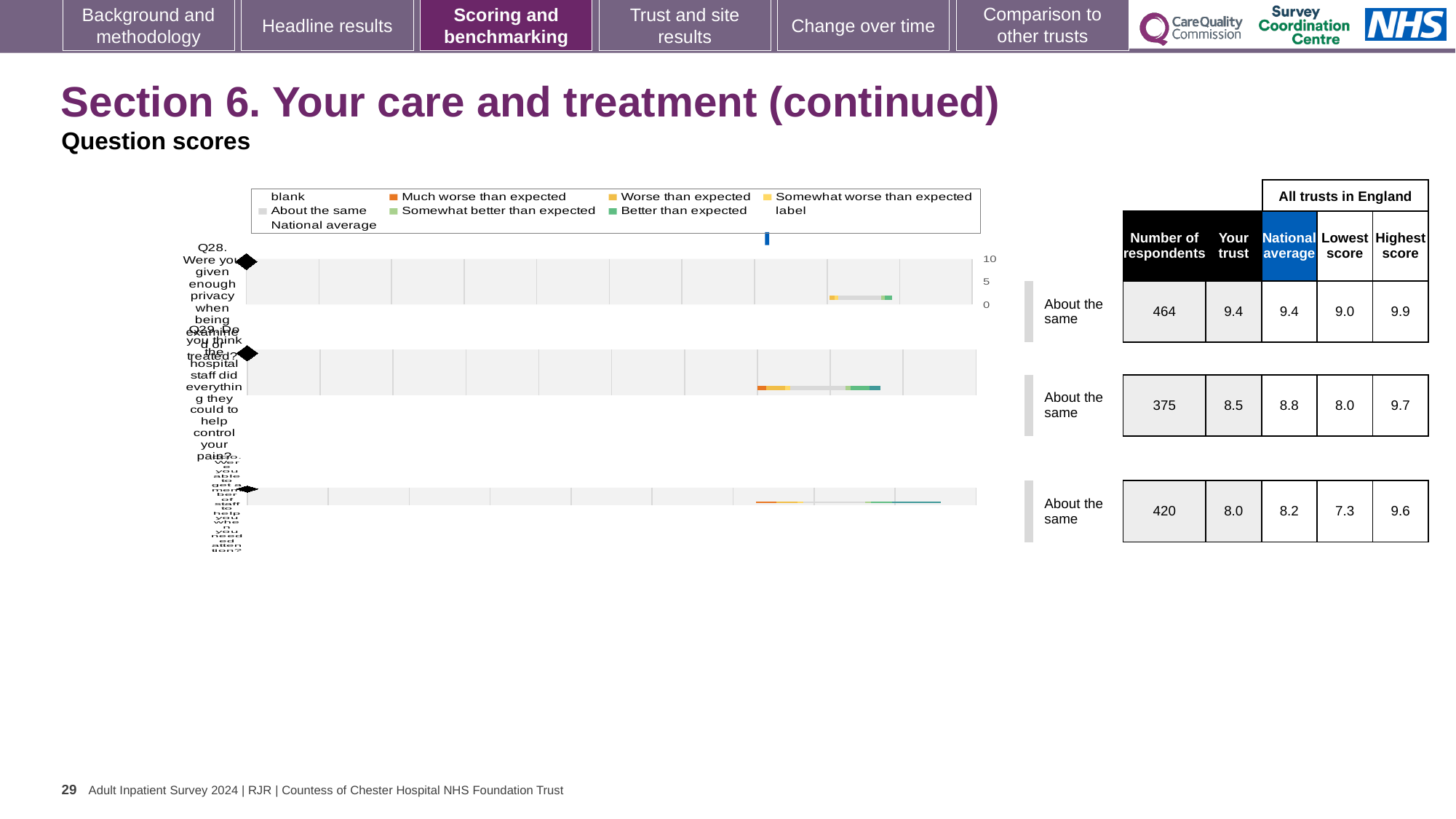
What benchmark category is shown next to each of the three question charts? About the same What is the lowest score among all trusts in England for Q30? 7.3 What is the 'Your trust' score for Q29 (staff did everything to help control your pain)? 8.5 What is the difference between the national average and the 'Your trust' score for Q29? 0.3 Which question has the highest 'Your trust' score? Q28 What is the highest score among all trusts in England for Q28? 9.9 Is the 'Your trust' score higher for Q28 or Q30? Q28 How many questions (Q28, Q29, Q30) are charted on this slide? 3 Which question has the lowest 'Your trust' score? Q30 What kind of chart is used to show the question scores on this slide? bar chart What is the number of respondents for Q28 (privacy when being examined or treated)? 464 What is the national average score for Q30? 8.2